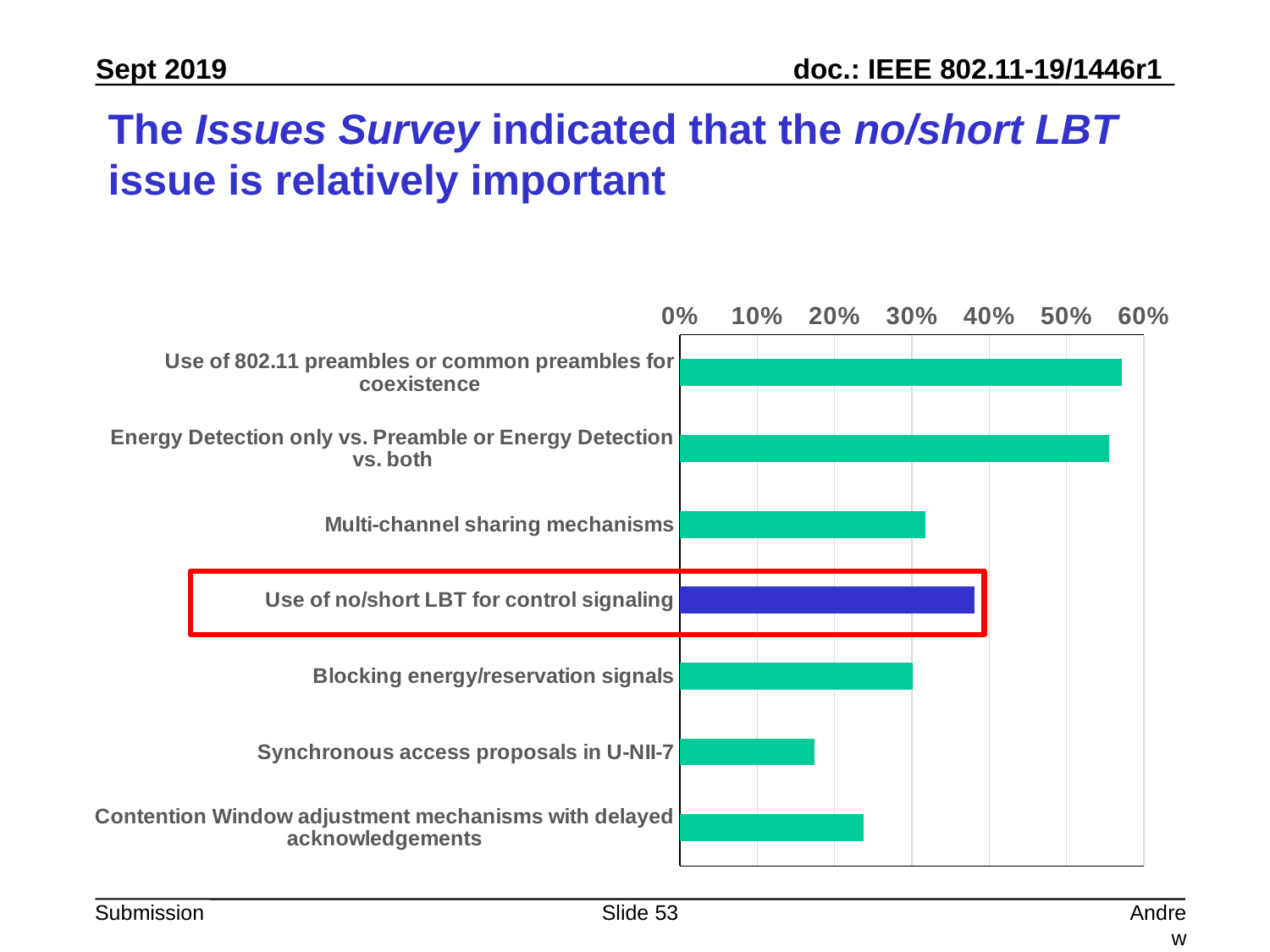
Is the value for "Synchronous access proposals in U-NII-7" greater or less than 20%? less What is the highest value shown on the chart's percentage axis? 60% Which has a larger value: "Contention Window adjustment mechanisms with delayed acknowledgements" or "Synchronous access proposals in U-NII-7"? Contention Window adjustment mechanisms with delayed acknowledgements Which category's bar is drawn in a different colour (dark blue) from the others? Use of no/short LBT for control signaling Which has a larger value: "Use of no/short LBT for control signaling" or "Multi-channel sharing mechanisms"? Use of no/short LBT for control signaling Is the value for "Energy Detection only vs. Preamble or Energy Detection vs. both" greater or less than 50%? greater How many categories are plotted in the chart? 7 What kind of chart is shown on the slide? bar chart Which category has the lowest value in the chart? Synchronous access proposals in U-NII-7 Is the value for "Contention Window adjustment mechanisms with delayed acknowledgements" greater or less than 30%? less